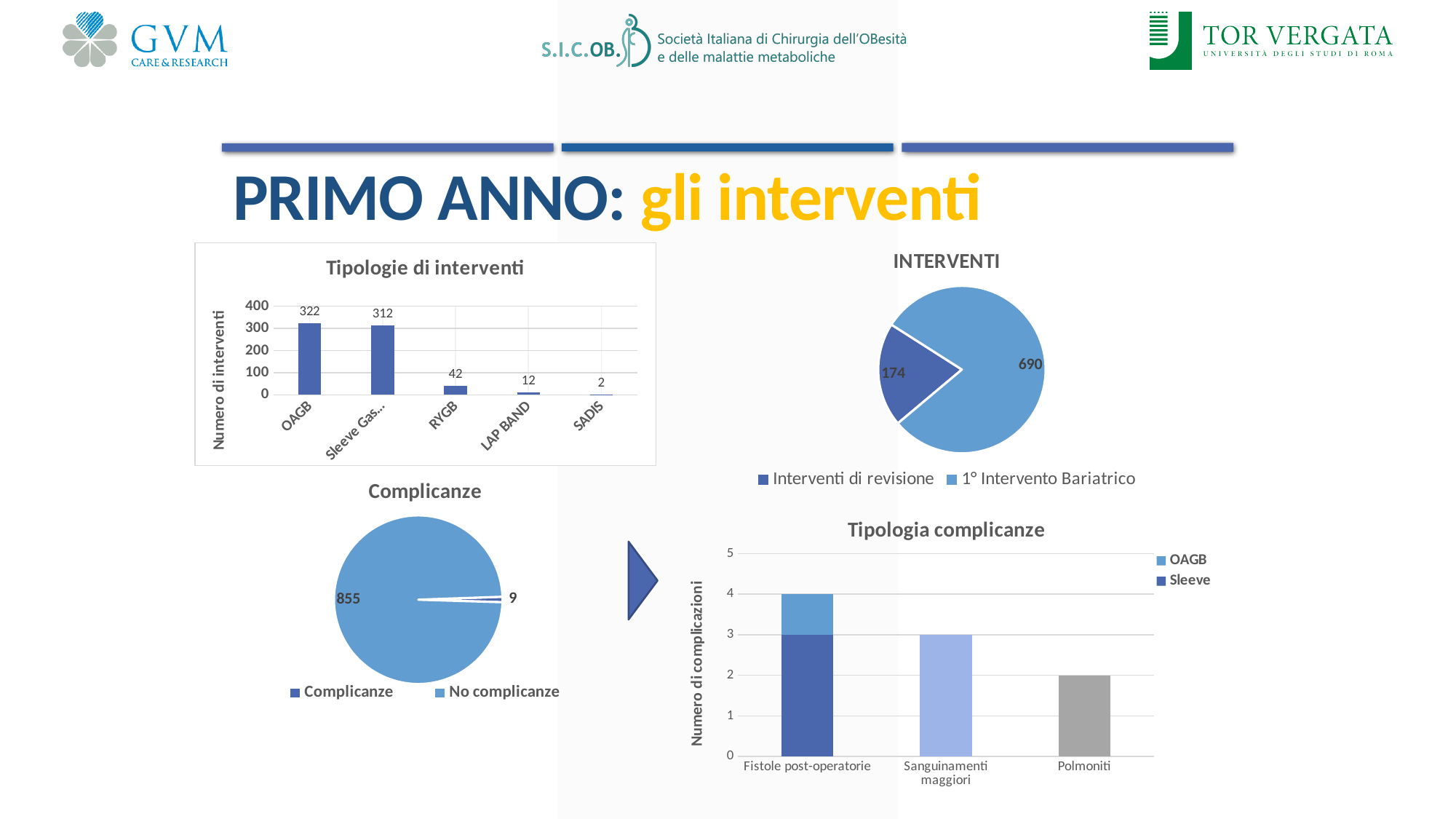
In the 'INTERVENTI' pie chart, what is the value for 'Interventi di revisione'? 174 In the 'Tipologie di interventi' chart, what is the difference between the OAGB and RYGB values? 280 What kind of chart is 'Tipologia complicanze'? bar chart In the 'Tipologie di interventi' chart, how many interventions are shown for OAGB? 322 In the 'Complicanze' pie chart, what is the value for 'No complicanze'? 855 In the 'INTERVENTI' pie chart, which slice is larger: 'Interventi di revisione' or '1° Intervento Bariatrico'? 1° Intervento Bariatrico In the 'Tipologia complicanze' chart, what is the value for Polmoniti? 2 In the 'Tipologie di interventi' chart, which category has the lowest number of interventions? SADIS How many series does the legend of the 'Tipologia complicanze' chart list? 2 In the 'Tipologie di interventi' chart, how many categories are plotted? 5 In the 'Tipologia complicanze' chart, what is the total height of the stacked bar for 'Fistole post-operatorie'? 4 In the 'Complicanze' pie chart, what is the difference between 'No complicanze' and 'Complicanze'? 846